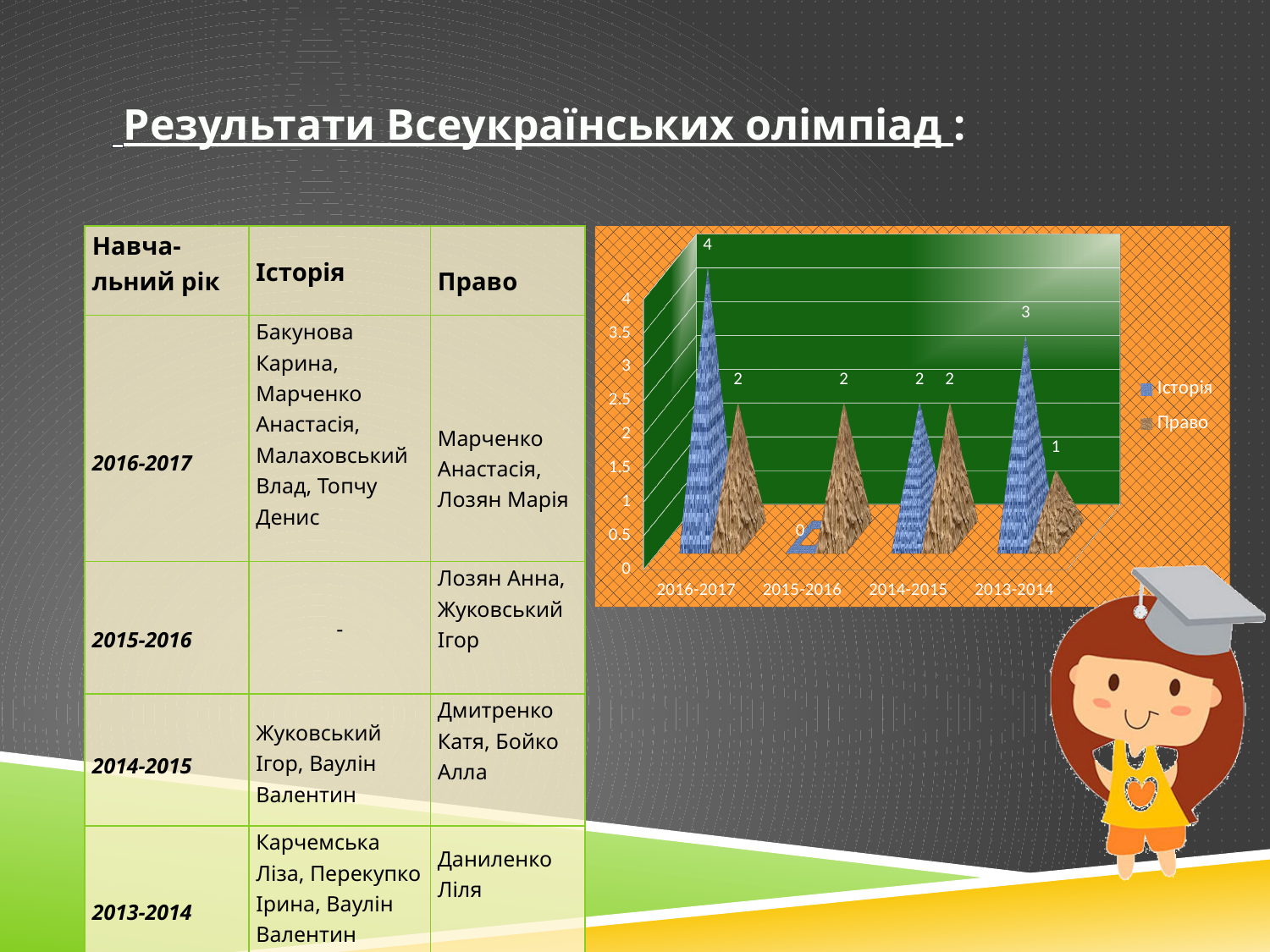
How many series does the legend list? 2 How many academic years are shown on the x axis? 4 In which academic year is the Право value lowest? 2013-2014 What is the total of the Історія and Право values in 2014-2015? 4 What is the value for Історія in 2016-2017? 4 What is the difference between the Історія and Право values in 2016-2017? 2 In which academic year is the Історія value highest? 2016-2017 What are the two series named in the legend? Історія and Право What is the value for Історія in 2015-2016? 0 Which is larger in 2013-2014, Історія or Право? Історія What is the value for Право in 2013-2014? 1 What is the value for Право in 2015-2016? 2